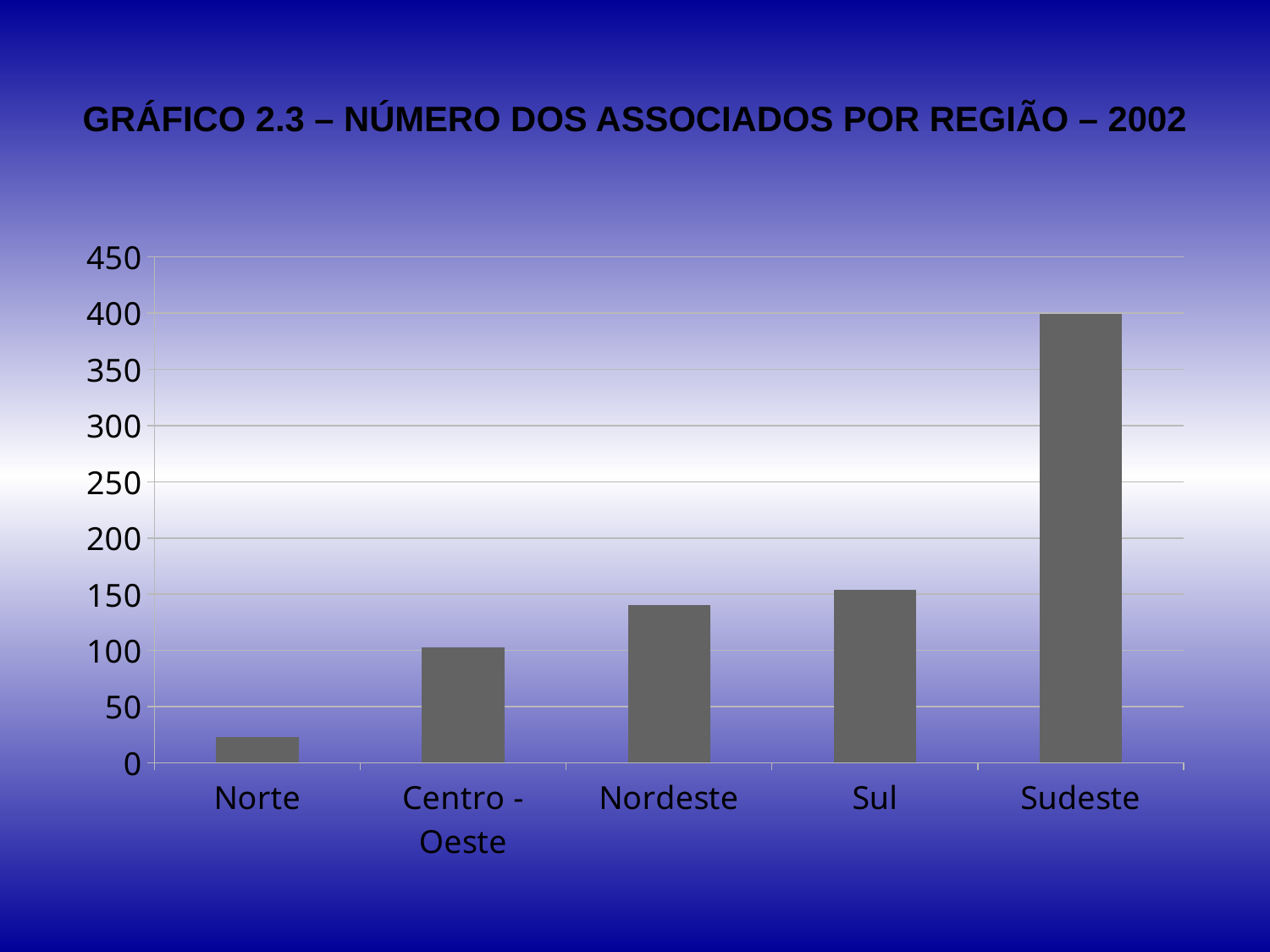
Is the value for Nordeste greater or less than 100? greater Which region has the highest number of associates? Sudeste Which has more associates, Sudeste or Sul? Sudeste What kind of chart is shown on the slide? bar chart How many regions are shown on the x axis of the chart? 5 Which has more associates, Norte or Centro - Oeste? Centro - Oeste Is the value for Centro - Oeste greater or less than 150? less Is the value for Sul greater or less than 200? less Which region has the lowest number of associates? Norte What is the title of the chart on the slide? GRÁFICO 2.3 – NÚMERO DOS ASSOCIADOS POR REGIÃO – 2002